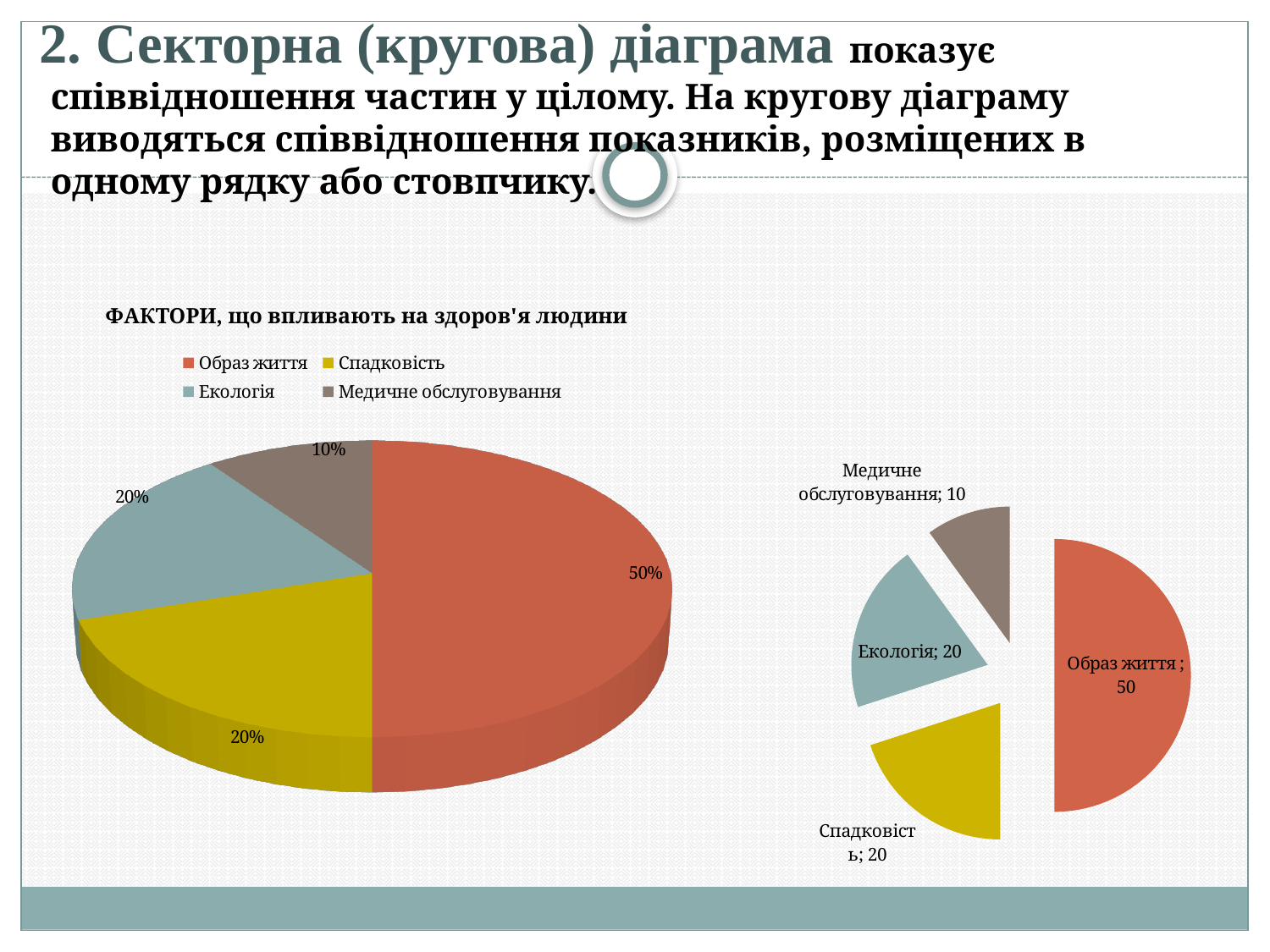
In the right pie chart, what value is shown for 'Екологія'? 20 What is the title of the left pie chart? ФАКТОРИ, що впливають на здоров'я людини What type of chart is the right chart on the slide? pie chart In the right pie chart, what is the difference between the values for 'Образ життя' and 'Медичне обслуговування'? 40 In the right pie chart, which category has the smallest slice? Медичне обслуговування What type of chart is the left chart titled 'ФАКТОРИ, що впливають на здоров'я людини'? pie chart In the right pie chart, which category has the largest slice? Образ життя In the right pie chart, which is larger: the value for 'Образ життя' or the value for 'Екологія'? Образ життя In the left pie chart, what percentage is shown for the 'Образ життя' slice? 50% How many entries does the legend of the left pie chart list? 4 In the left pie chart, what percentage is shown for the 'Медичне обслуговування' slice? 10% In the right pie chart, what value is shown for 'Спадковість'? 20